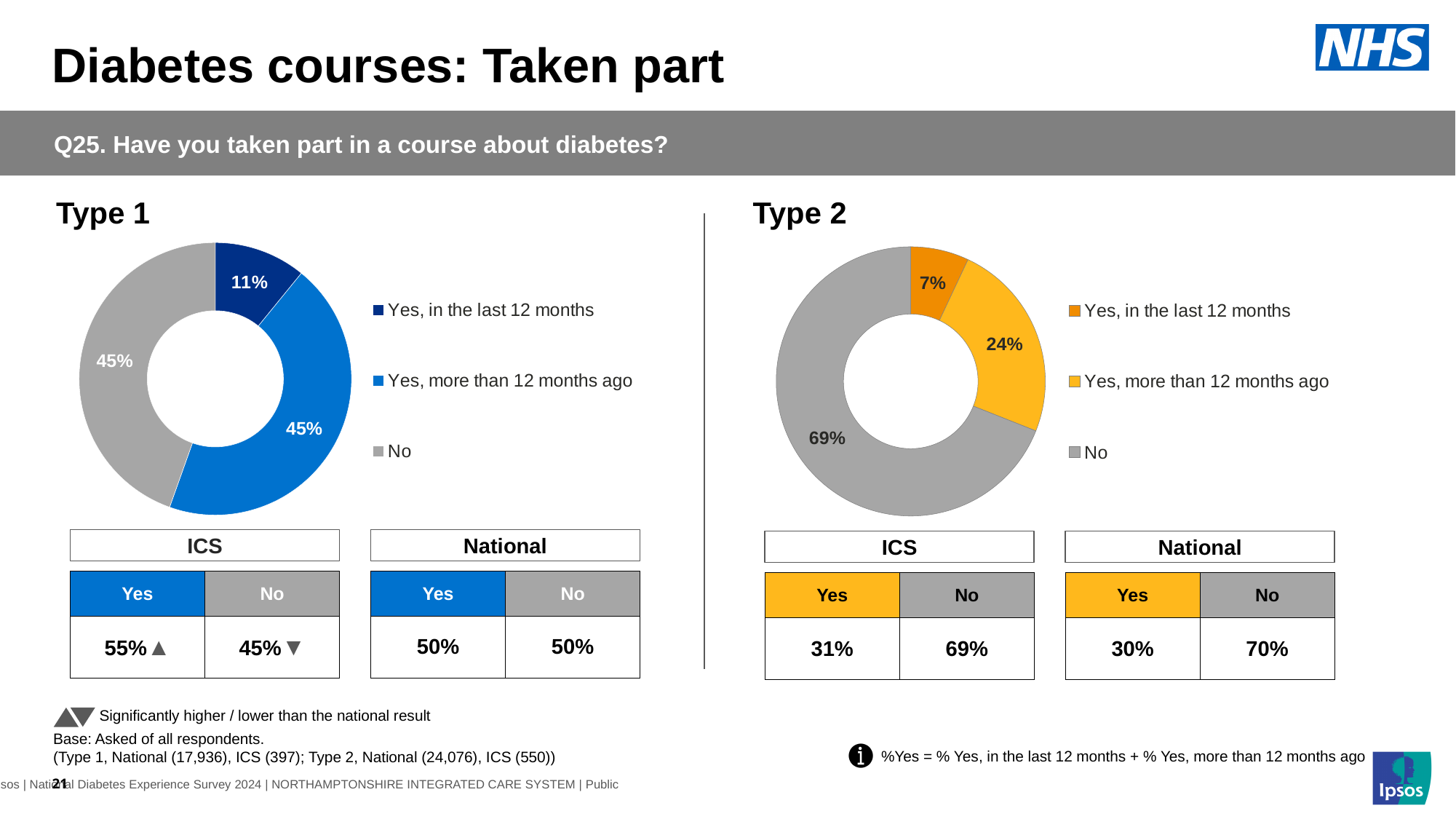
In the Type 2 chart, what colour represents 'No'? Grey Is the 'Yes, in the last 12 months' share larger in the Type 1 chart or the Type 2 chart? Type 1 In the Type 2 chart, what is the difference between the 'No' share and the 'Yes, more than 12 months ago' share? 45 percentage points In the Type 1 chart, which response has the smallest share? Yes, in the last 12 months In the Type 1 chart, what percentage of respondents answered 'Yes, in the last 12 months'? 11% In the Type 1 chart, what is the difference between the 'No' share and the 'Yes, in the last 12 months' share? 34 percentage points What kind of chart is used for Type 1? Donut chart In the Type 2 chart, which response has the smallest share? Yes, in the last 12 months In the Type 2 chart, what percentage of respondents answered 'No'? 69% In the Type 2 chart, which response has the largest share? No How many response categories does the Type 2 chart show? 3 In the Type 2 chart, what percentage answered 'Yes, more than 12 months ago'? 24%